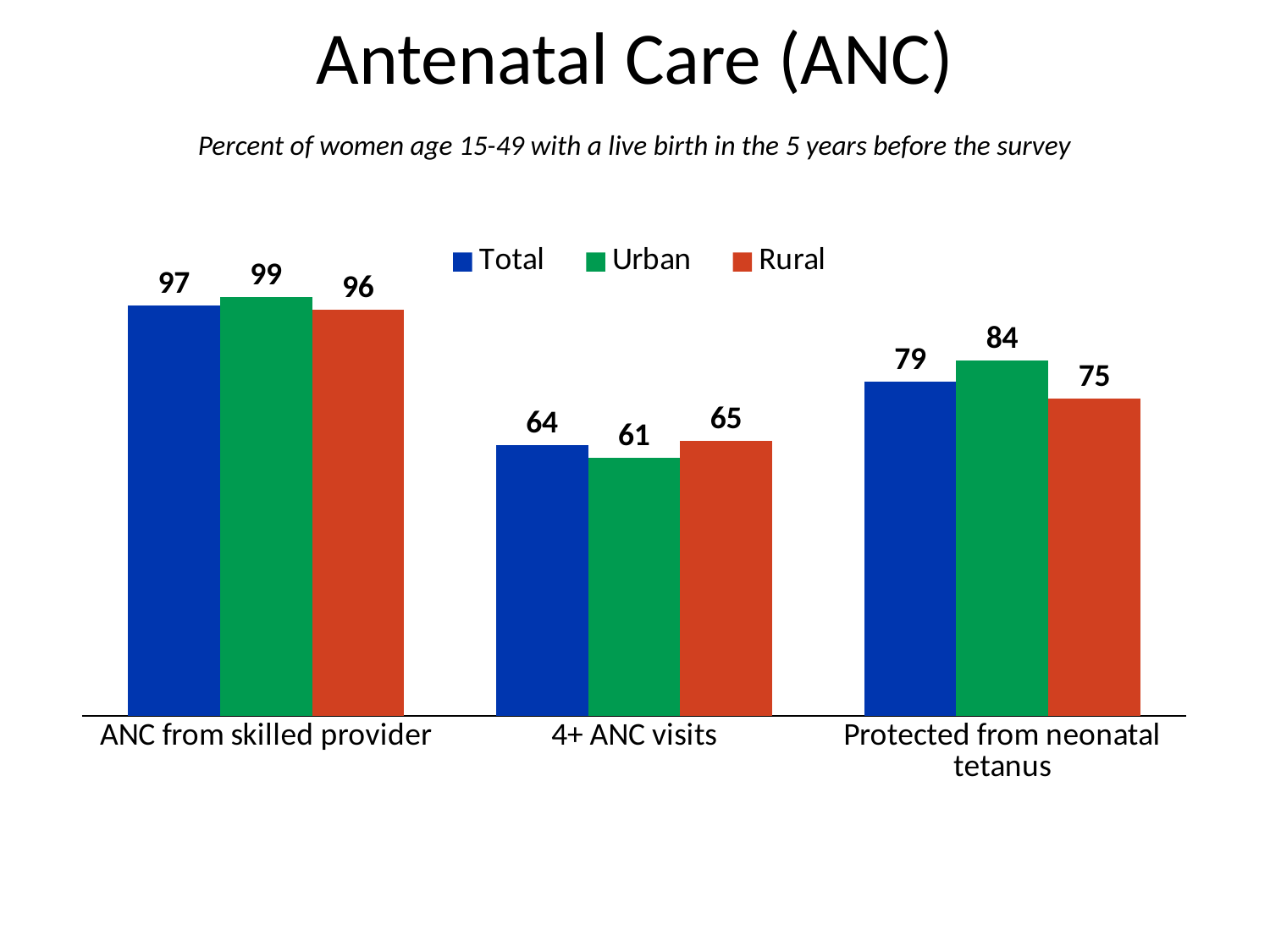
How many series does the legend list? 3 What is the difference between the Urban and Rural values for Protected from neonatal tetanus? 9 What is the Rural value for Protected from neonatal tetanus? 75 For 4+ ANC visits, which is larger, the Urban value or the Rural value? Rural Which category has the lowest Total value? 4+ ANC visits What is the Total value for ANC from skilled provider? 97 What kind of chart is shown on the slide? Bar chart How many categories are shown on the x axis? 3 Which category has the highest Urban value? ANC from skilled provider What is the difference between the Total values for ANC from skilled provider and 4+ ANC visits? 33 What is the Urban value for 4+ ANC visits? 61 Which series is shown in green in the legend? Urban